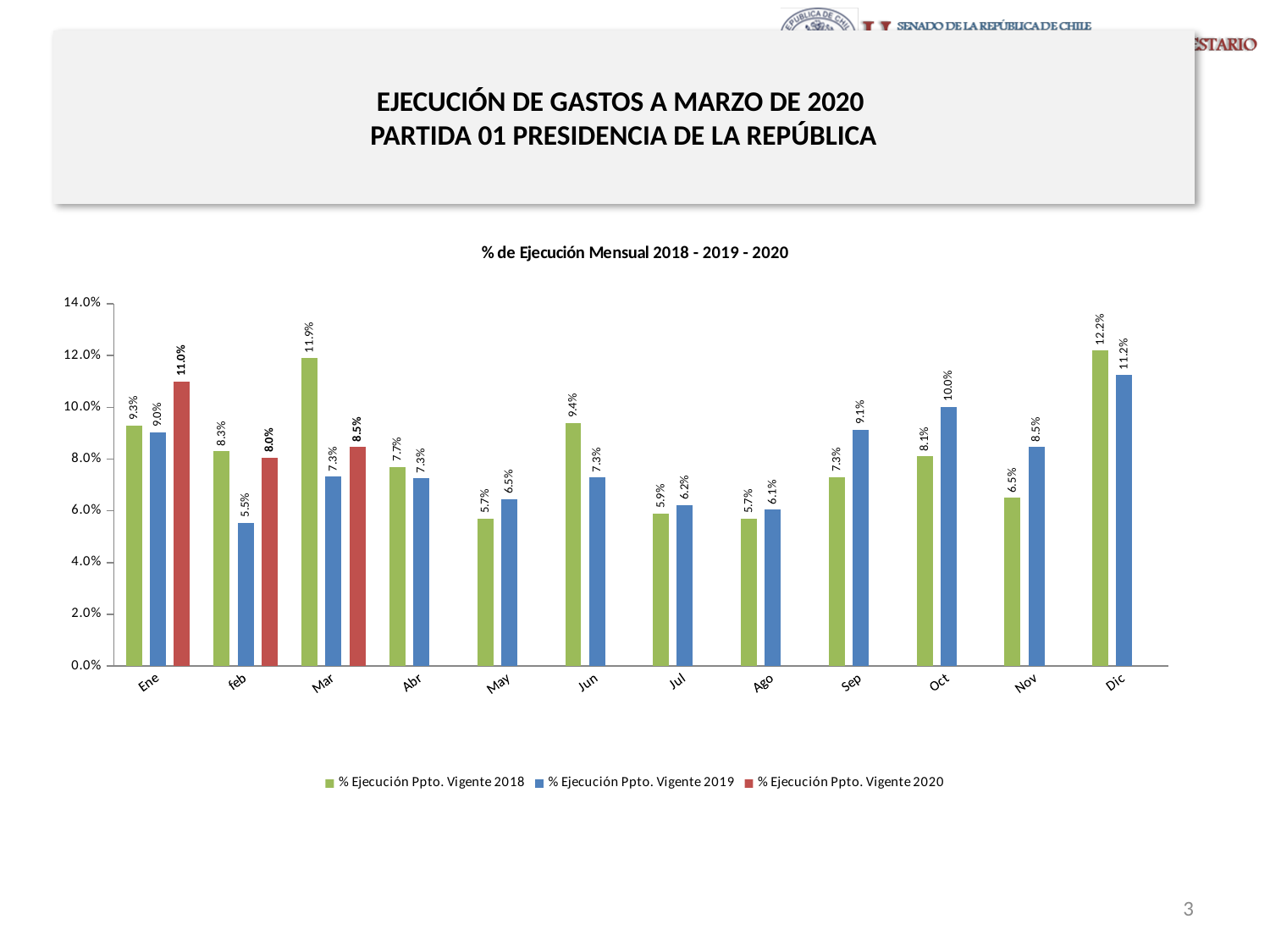
How many months are shown on the x axis? 12 What is the difference between the 2018 and 2019 values in Mar? 4.6% Which month has the highest value for % Ejecución Ppto. Vigente 2019? Dic In Oct, which series is larger: % Ejecución Ppto. Vigente 2018 or % Ejecución Ppto. Vigente 2019? % Ejecución Ppto. Vigente 2019 How many series does the legend list? 3 What is the title of the chart? % de Ejecución Mensual 2018 - 2019 - 2020 What is the value for % Ejecución Ppto. Vigente 2018 in Dic? 12.2% What kind of chart is shown on the slide? bar chart Which month has the lowest value for % Ejecución Ppto. Vigente 2019? feb Is the value for % Ejecución Ppto. Vigente 2018 in Jun greater or less than 8.0%? greater What is the value for % Ejecución Ppto. Vigente 2020 in Ene? 11.0% What is the value for % Ejecución Ppto. Vigente 2019 in feb? 5.5%